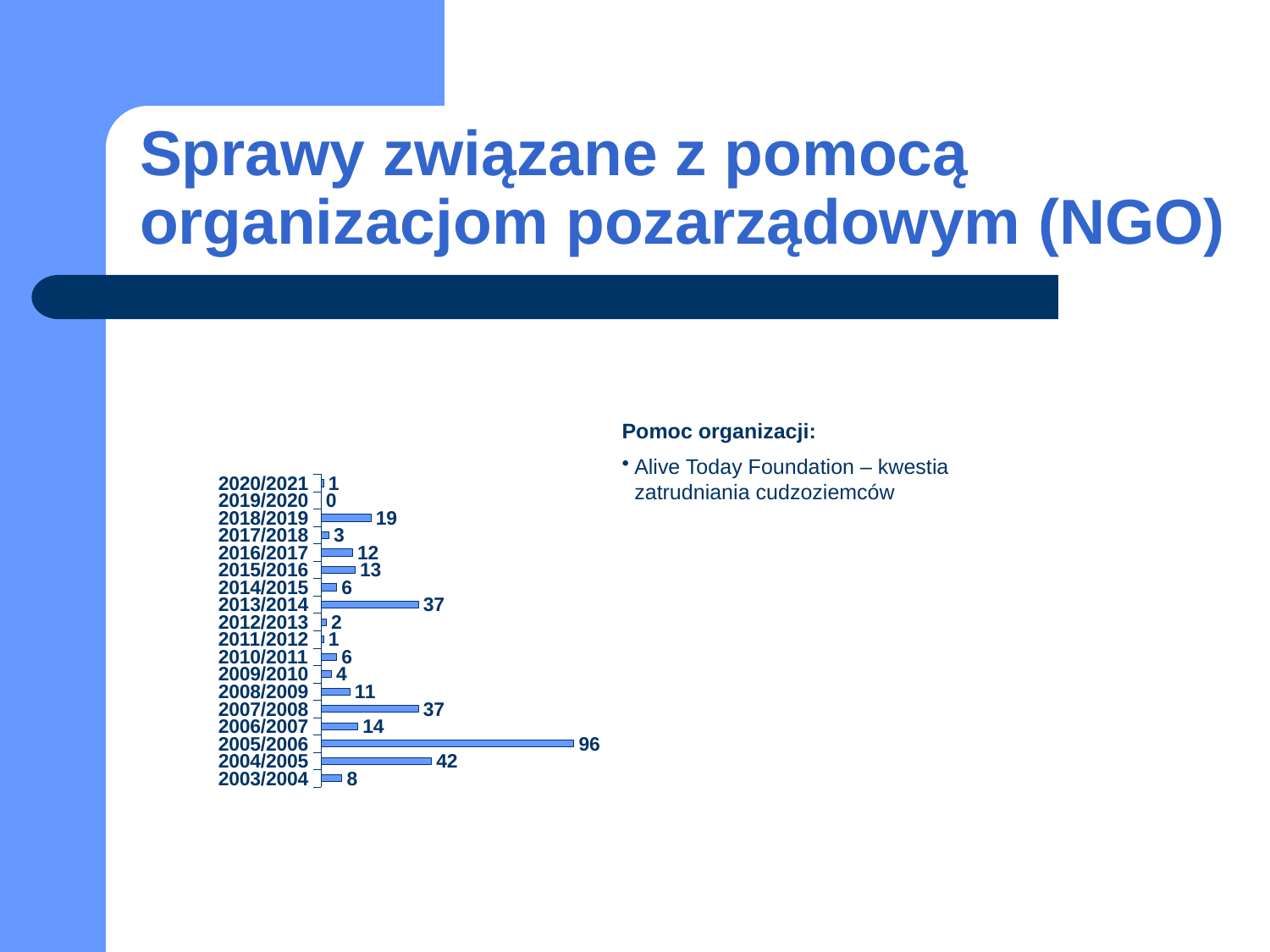
What is the value for 2013/2014? 37 What is the difference between the values for 2005/2006 and 2004/2005? 54 What kind of chart is shown on the slide? bar chart What is the value for 2005/2006? 96 Which category has the highest value? 2005/2006 Which category has the lowest value? 2019/2020 Which two categories share the value 37? 2013/2014 and 2007/2008 What is the difference between the values for 2016/2017 and 2015/2016? 1 What is the value for 2018/2019? 19 How many categories are shown in the chart? 18 What is the value for 2003/2004? 8 Which is larger, the value for 2006/2007 or the value for 2008/2009? 2006/2007